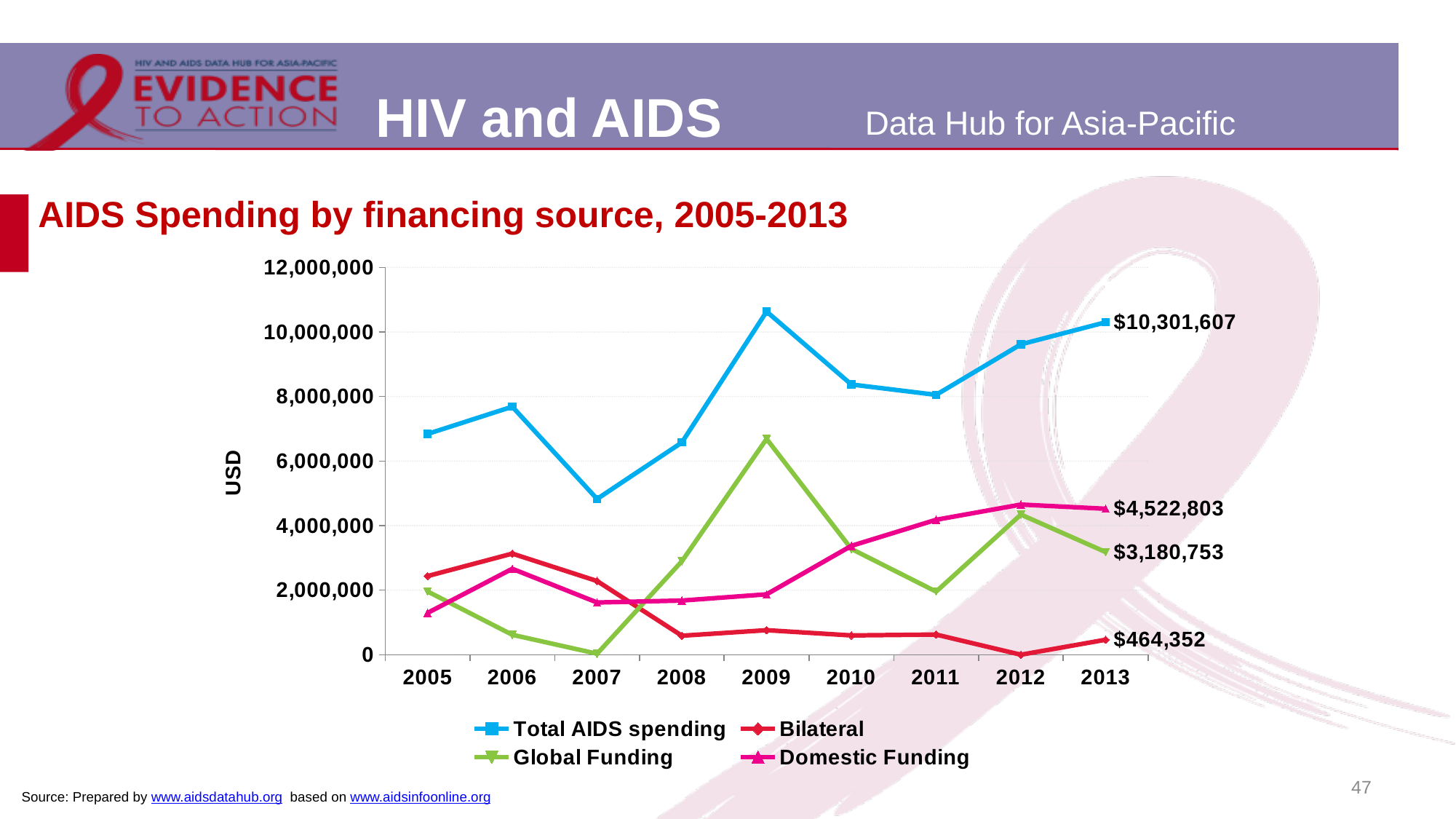
In which year was Total AIDS spending lowest? 2007 How many series does the legend list? 4 What kind of chart is shown on the slide? Line chart What is the value of Domestic Funding in 2013? $4,522,803 How many years are shown on the x axis? 9 What is the value of Total AIDS spending in 2013? $10,301,607 What is the difference between Domestic Funding and Global Funding in 2013? $1,342,050 What is the value of Bilateral funding in 2013? $464,352 In which year was Total AIDS spending highest? 2009 In 2013, which is larger: Domestic Funding or Global Funding? Domestic Funding Is the value for Total AIDS spending in 2009 greater or less than 10,000,000? greater What is the value of Global Funding in 2013? $3,180,753